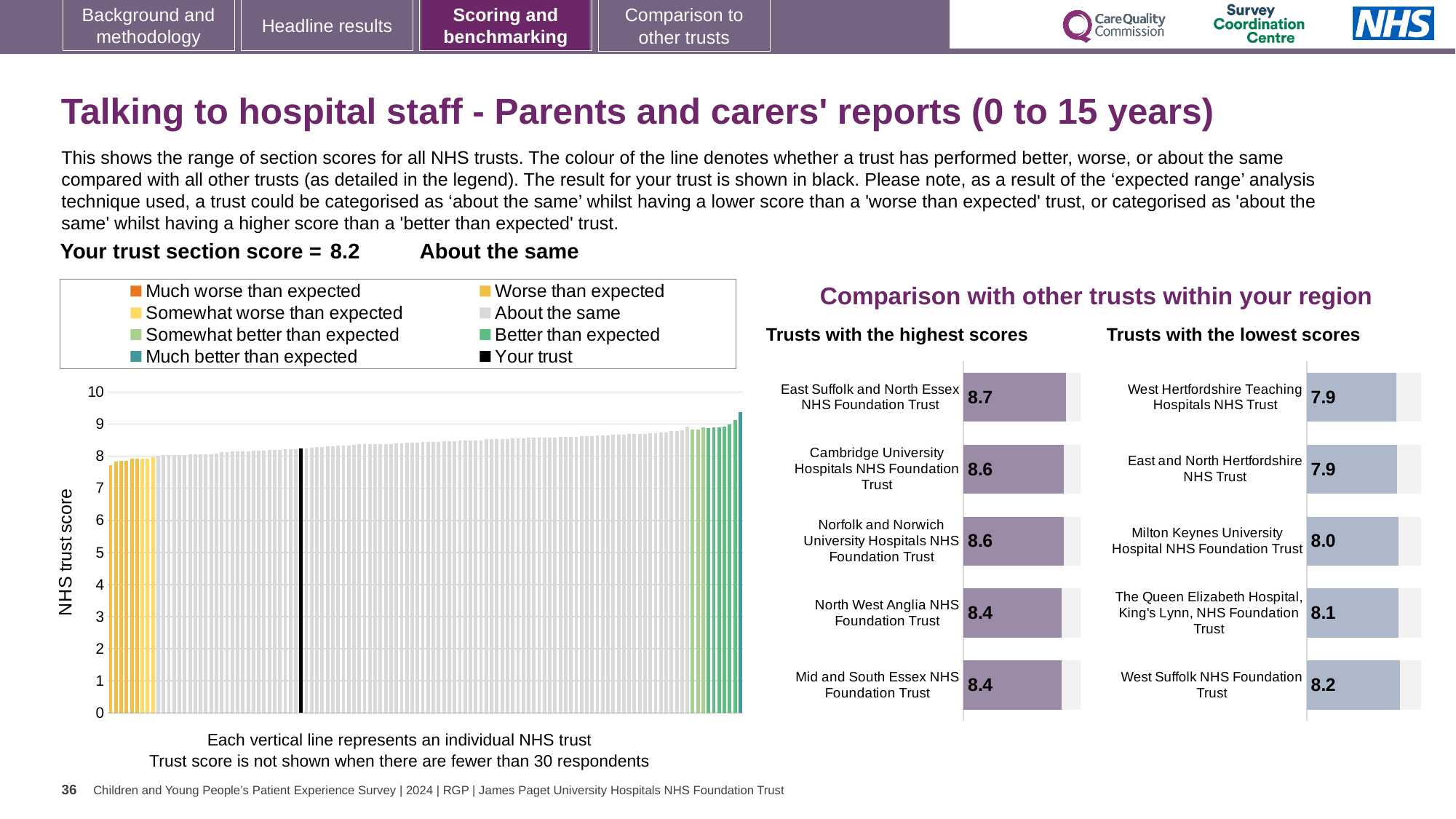
How many trusts are shown in the 'Trusts with the lowest scores' chart? 5 How many entries does the legend of the NHS trust score chart on the left list? 8 In the 'Trusts with the highest scores' chart, what is the score for East Suffolk and North Essex NHS Foundation Trust? 8.7 In the NHS trust score chart on the left, is the value of the tallest bar greater or less than 9? greater In the 'Trusts with the lowest scores' chart, what is the score for Milton Keynes University Hospital NHS Foundation Trust? 8.0 What kind of chart is the NHS trust score chart on the left of the slide? Bar chart In the 'Trusts with the highest scores' chart, what is the score for North West Anglia NHS Foundation Trust? 8.4 In the NHS trust score chart on the left, do the bar values rise or fall from left to right along the x axis? Rise In the 'Trusts with the highest scores' chart, which trust has the highest score? East Suffolk and North Essex NHS Foundation Trust In the 'Trusts with the lowest scores' chart, which has the larger score: West Suffolk NHS Foundation Trust or West Hertfordshire Teaching Hospitals NHS Trust? West Suffolk NHS Foundation Trust In the 'Trusts with the highest scores' chart, what is the difference between the scores of East Suffolk and North Essex NHS Foundation Trust and Mid and South Essex NHS Foundation Trust? 0.3 In the 'Trusts with the lowest scores' chart, which trust has the highest score? West Suffolk NHS Foundation Trust